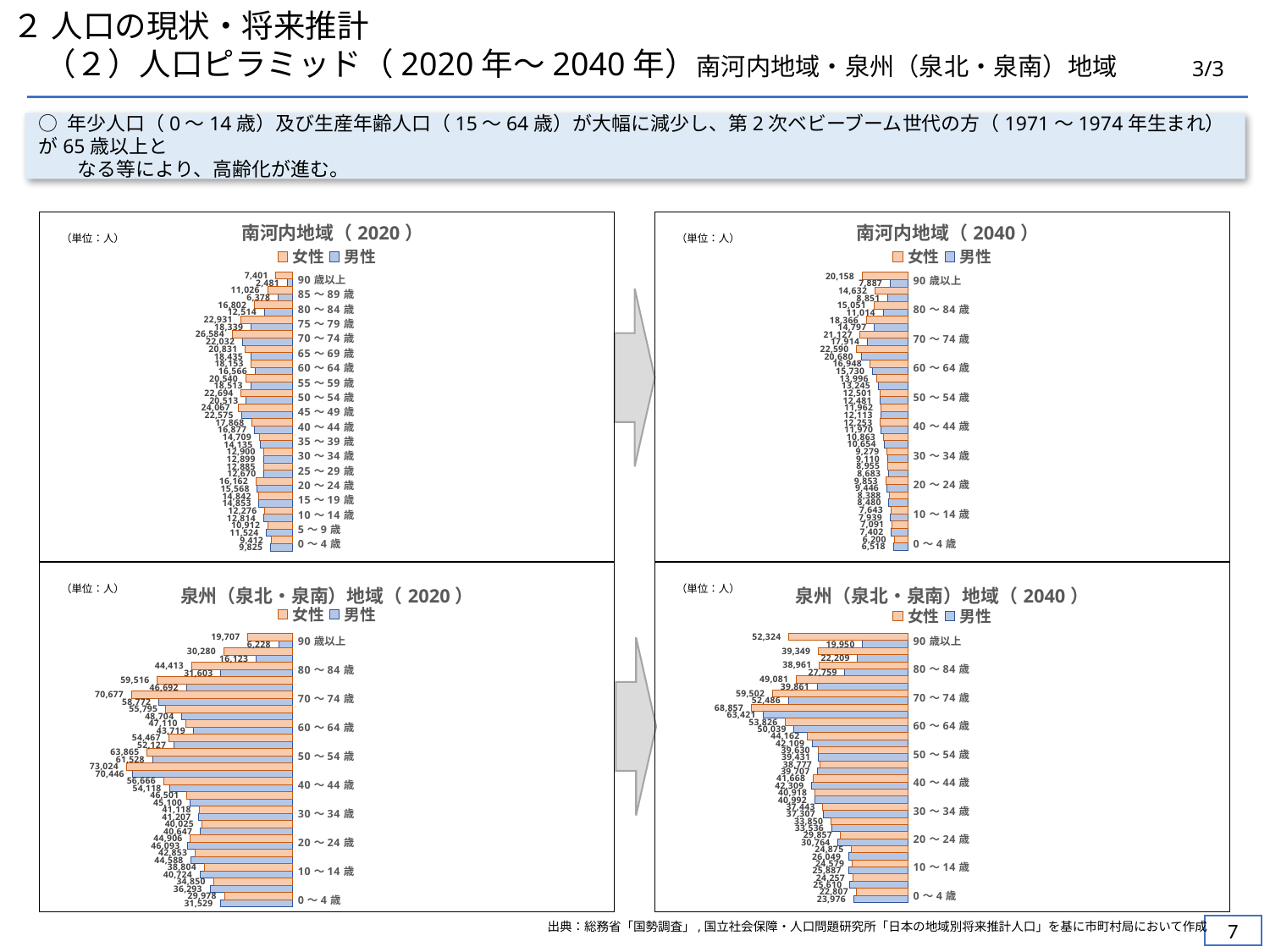
In the 泉州（泉北・泉南）地域（2040） chart, what is the value for 女性 in the 90歳以上 age group? 52,324 How many series does the legend of the 泉州（泉北・泉南）地域（2040） chart list? 2 In the 南河内地域（2020） chart, what is the value for 男性 in the 0～4歳 age group? 9,825 In the 南河内地域（2040） chart, what is the value for 男性 in the 65～69歳 age group? 20,680 In the 南河内地域（2040） chart, what is the value for 女性 in the 90歳以上 age group? 20,158 In the 南河内地域（2020） chart, which is larger in the 70～74歳 age group, 女性 or 男性? 女性 What kind of chart is the 南河内地域（2040） chart? Bar chart In the 泉州（泉北・泉南）地域（2020） chart, what is the value for 男性 in the 90歳以上 age group? 6,228 In the 泉州（泉北・泉南）地域（2040） chart, what is the difference between the 女性 and 男性 values in the 90歳以上 age group? 32,374 In the 泉州（泉北・泉南）地域（2020） chart, which age group has the highest 女性 value? 45～49歳 In the 南河内地域（2020） chart, what is the value for 女性 in the 90歳以上 age group? 7,401 How many age groups are plotted in the 南河内地域（2020） chart? 19